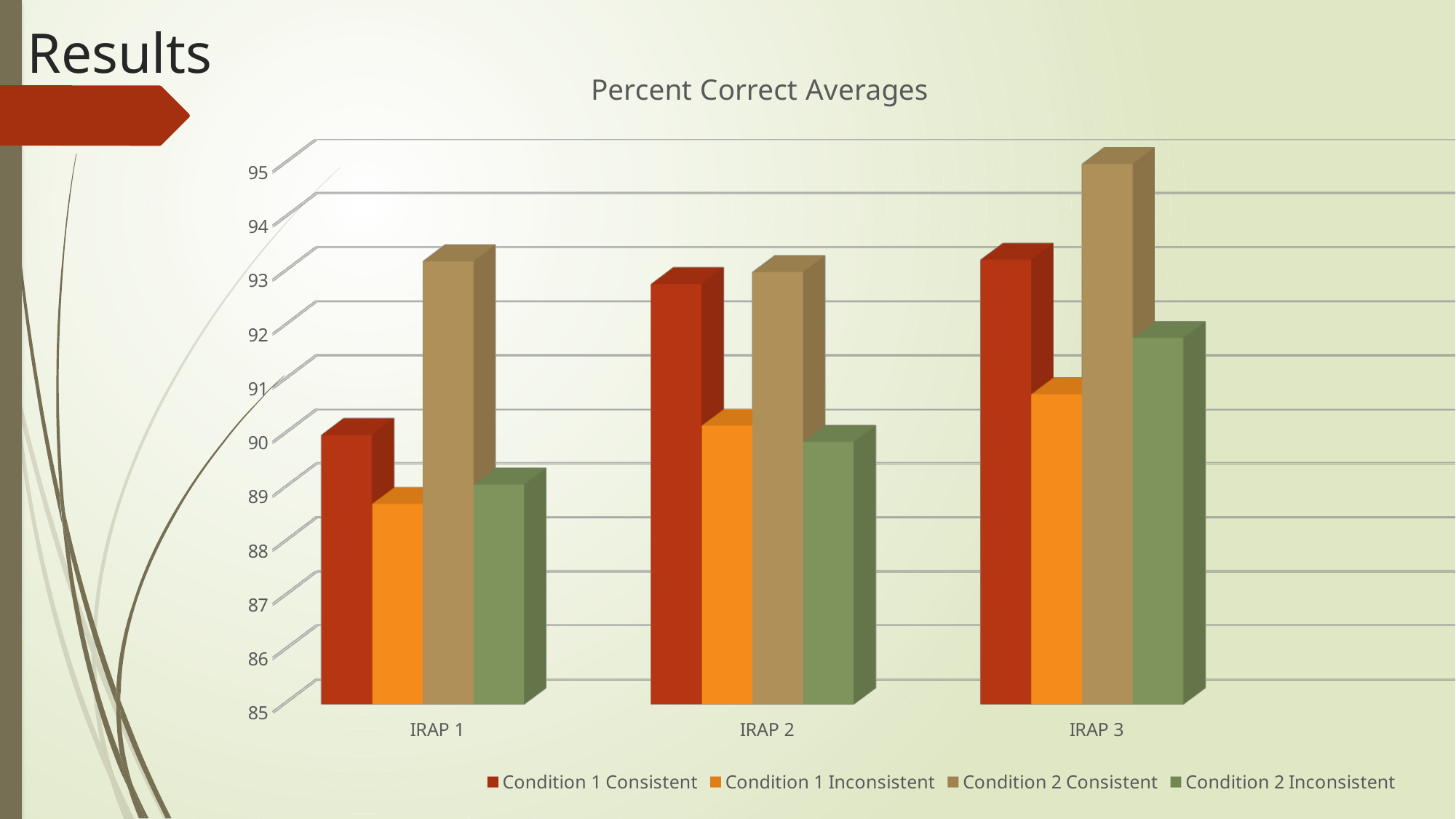
How many series does the legend list? 4 For IRAP 3, which is larger: Condition 1 Inconsistent or Condition 2 Inconsistent? Condition 2 Inconsistent Is the value for Condition 1 Inconsistent at IRAP 1 greater or less than 90? less What kind of chart is shown on the slide? bar chart Which category has the lowest value for Condition 1 Consistent? IRAP 1 Do the values for Condition 1 Consistent rise or fall from IRAP 1 to IRAP 3? rise Which series and category has the highest bar in the chart? Condition 2 Consistent, IRAP 3 What is the title of the chart? Percent Correct Averages Is the value for Condition 1 Consistent at IRAP 2 greater or less than 92? greater How many categories are shown on the x axis? 3 For IRAP 1, which is larger: Condition 1 Consistent or Condition 2 Consistent? Condition 2 Consistent Is the value for Condition 2 Consistent at IRAP 3 greater or less than 94? greater